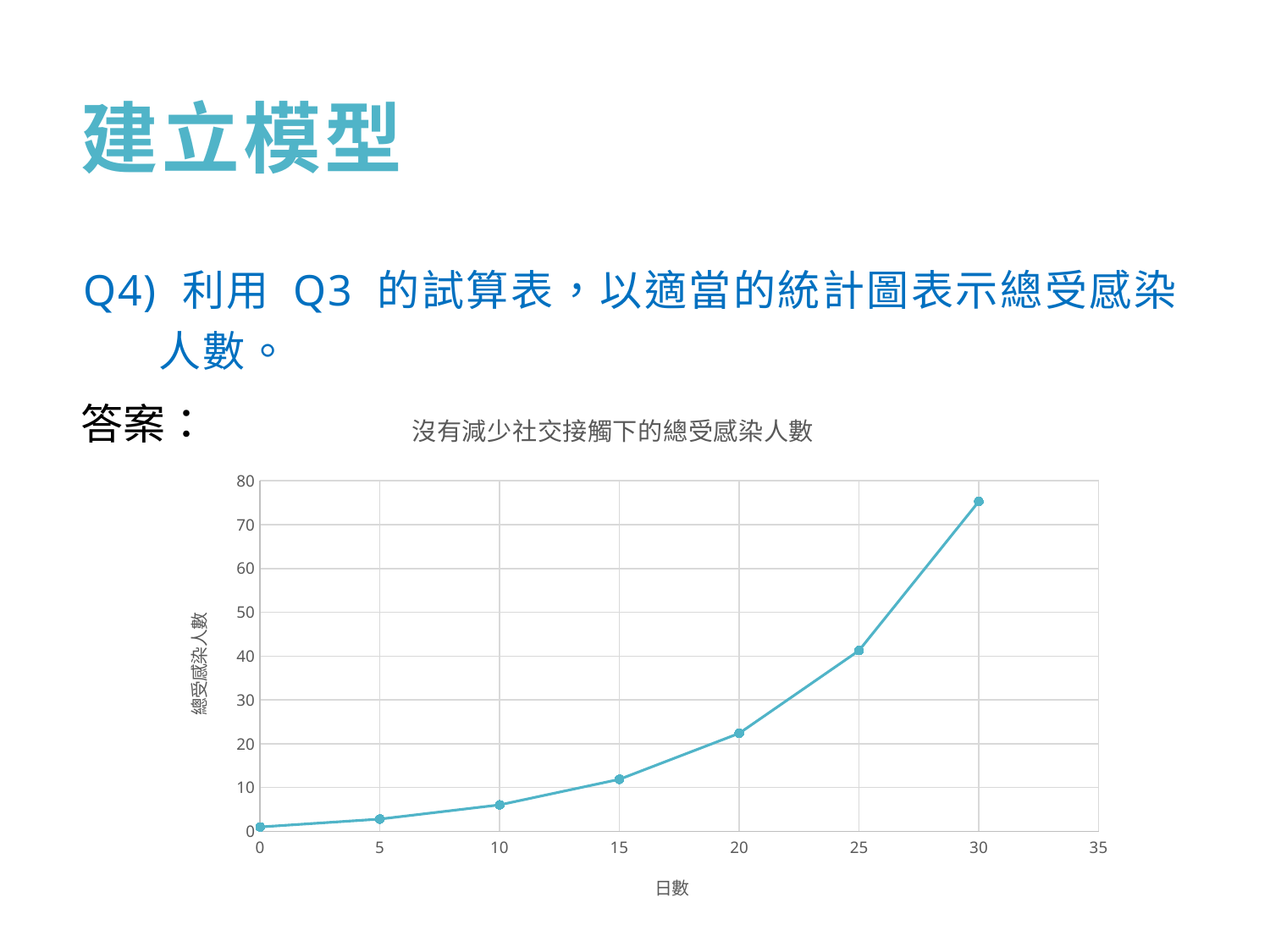
Which is larger, the value at day 25 or the value at day 15? day 25 What is the label of the x axis of the chart? 日數 How many data points are plotted on the line? 7 Is the value at day 10 greater or less than 10? less At which day is the total number of infected people lowest? 0 What is the title of the chart? 沒有減少社交接觸下的總受感染人數 Do the values rise or fall as the number of days increases? rise What kind of chart is shown on the slide? line chart Is the value at day 25 greater or less than 50? less At which day is the total number of infected people highest? 30 Is the value at day 30 greater or less than 70? greater